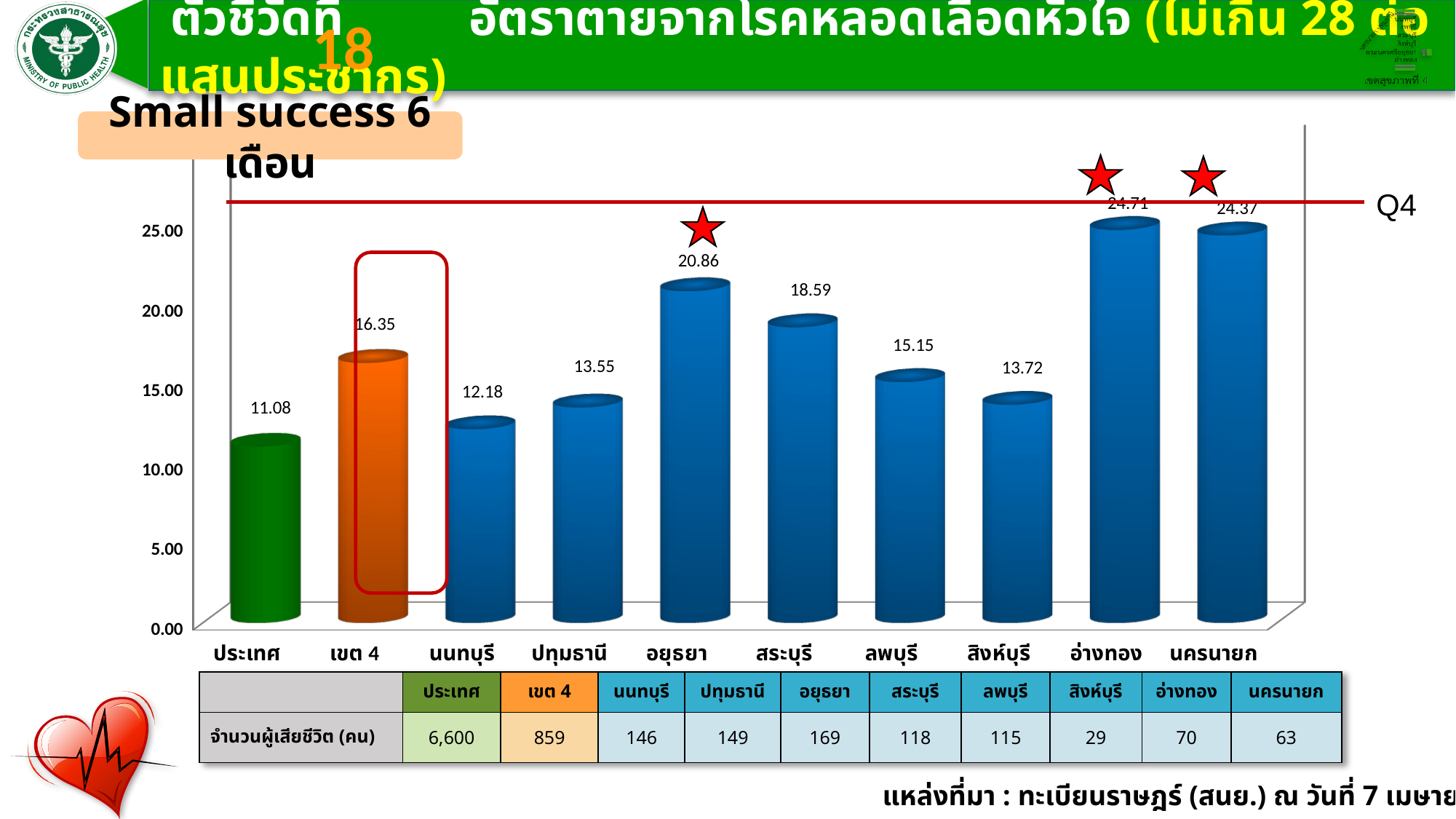
Which is larger, the value for ปทุมธานี or the value for นนทบุรี? ปทุมธานี What is the difference between the values for สระบุรี and ลพบุรี? 3.44 Which category has the lowest value? ประเทศ What is the value for อยุธยา? 20.86 What colour is the bar for เขต 4? orange What is the difference between the values for อ่างทอง and ประเทศ? 13.63 Is the value for นครนายก greater or less than 20.00? greater What is the value for สิงห์บุรี? 13.72 How many categories are shown on the x axis of the chart? 10 What is the value for เขต 4? 16.35 What kind of chart is shown on the slide? bar chart Which category has the highest value? อ่างทอง